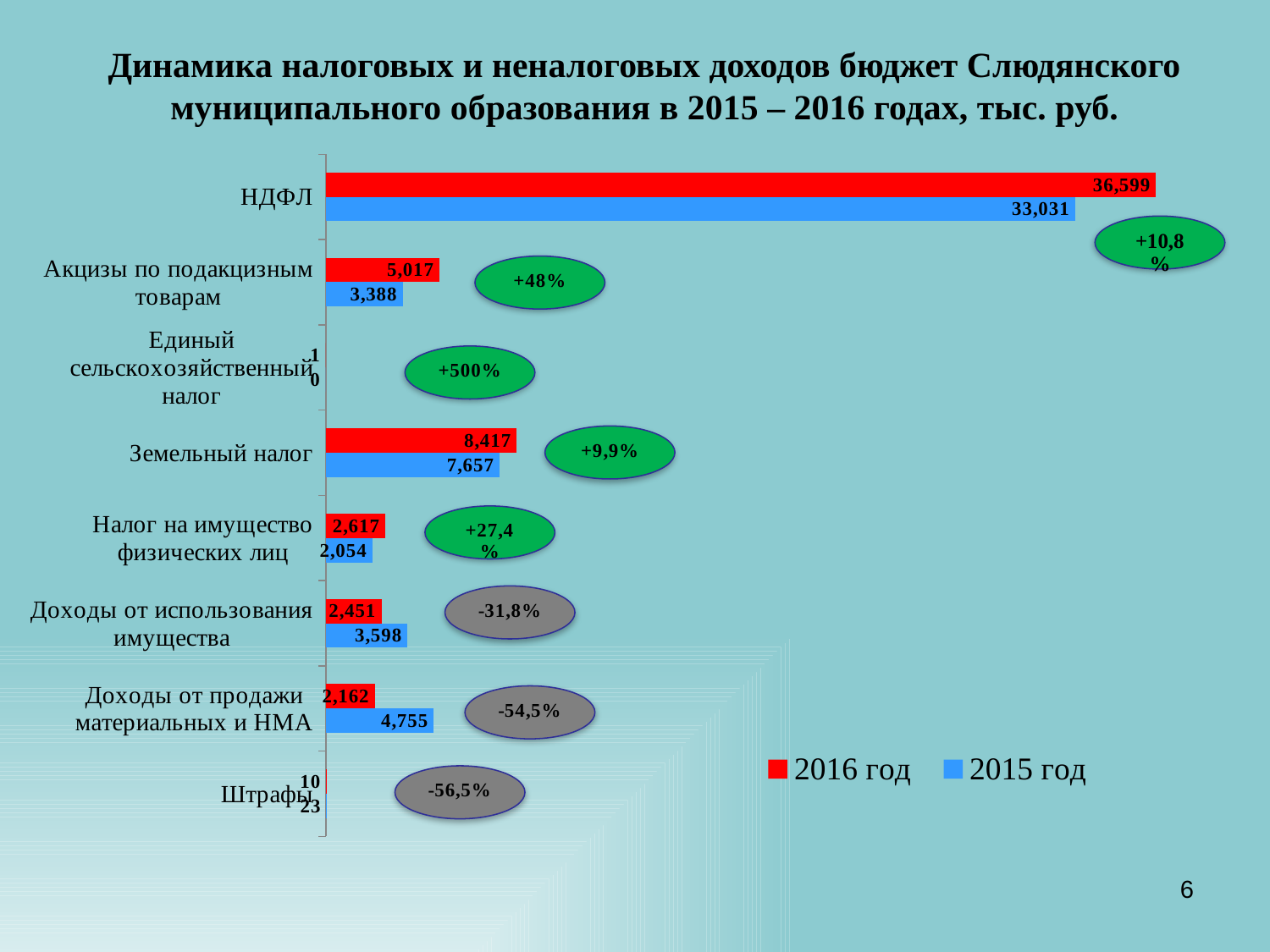
What is the 2016 год value for Доходы от продажи материальных и НМА? 2,162 What is the 2016 год value for НДФЛ? 36,599 How many categories are shown on the chart? 8 What percentage change is shown in the oval next to Земельный налог? +9,9% Which category has the lowest 2015 год value? Единый сельскохозяйственный налог For Доходы от использования имущества, which is larger: the 2016 год value or the 2015 год value? 2015 год Which category has the highest 2016 год value? НДФЛ What is the difference between the 2016 год and 2015 год values for Акцизы по подакцизным товарам? 1,629 What is the 2015 год value for Земельный налог? 7,657 What kind of chart is shown on the slide? Bar chart How many series does the legend list? 2 What is the 2015 год value for Штрафы? 23